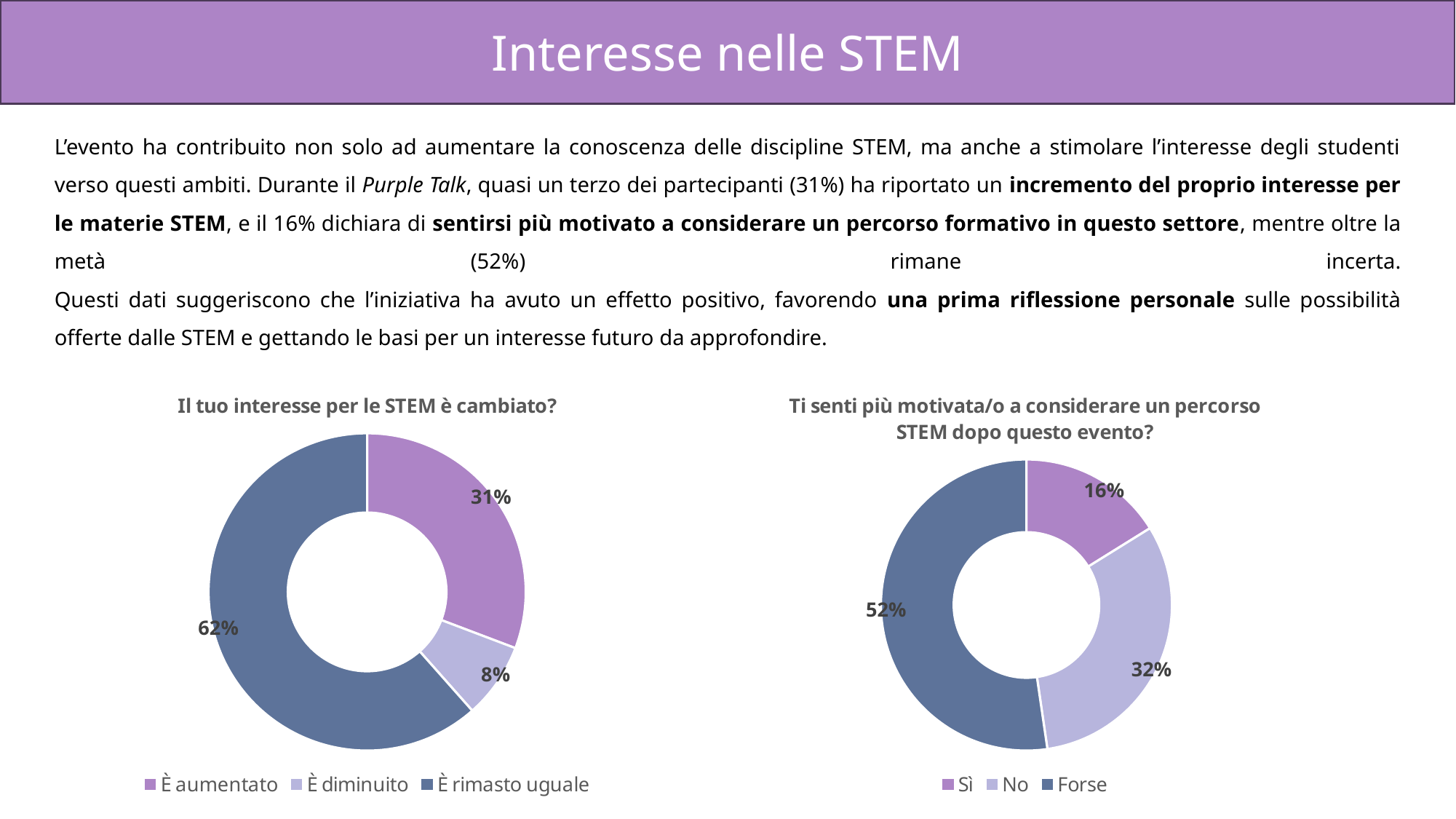
In the chart 'Il tuo interesse per le STEM è cambiato?', which category has the smallest share? È diminuito In the chart 'Ti senti più motivata/o a considerare un percorso STEM dopo questo evento?', what is the difference between the shares for 'No' and 'Sì'? 16% In the chart 'Ti senti più motivata/o a considerare un percorso STEM dopo questo evento?', what percentage answered 'Forse'? 52% What kind of chart is 'Ti senti più motivata/o a considerare un percorso STEM dopo questo evento?'? Doughnut (pie) chart In the chart 'Il tuo interesse per le STEM è cambiato?', which category has the largest share? È rimasto uguale How many categories does the legend of the chart 'Il tuo interesse per le STEM è cambiato?' list? 3 In the chart 'Il tuo interesse per le STEM è cambiato?', what percentage is shown for 'È aumentato'? 31% In the chart 'Ti senti più motivata/o a considerare un percorso STEM dopo questo evento?', which answer has the largest share? Forse In the chart 'Il tuo interesse per le STEM è cambiato?', what is the difference between the shares for 'È rimasto uguale' and 'È aumentato'? 31% In the chart 'Il tuo interesse per le STEM è cambiato?', what percentage is shown for 'È diminuito'? 8% In the chart 'Ti senti più motivata/o a considerare un percorso STEM dopo questo evento?', which is larger, 'No' or 'Sì'? No In the chart 'Ti senti più motivata/o a considerare un percorso STEM dopo questo evento?', what percentage answered 'Sì'? 16%